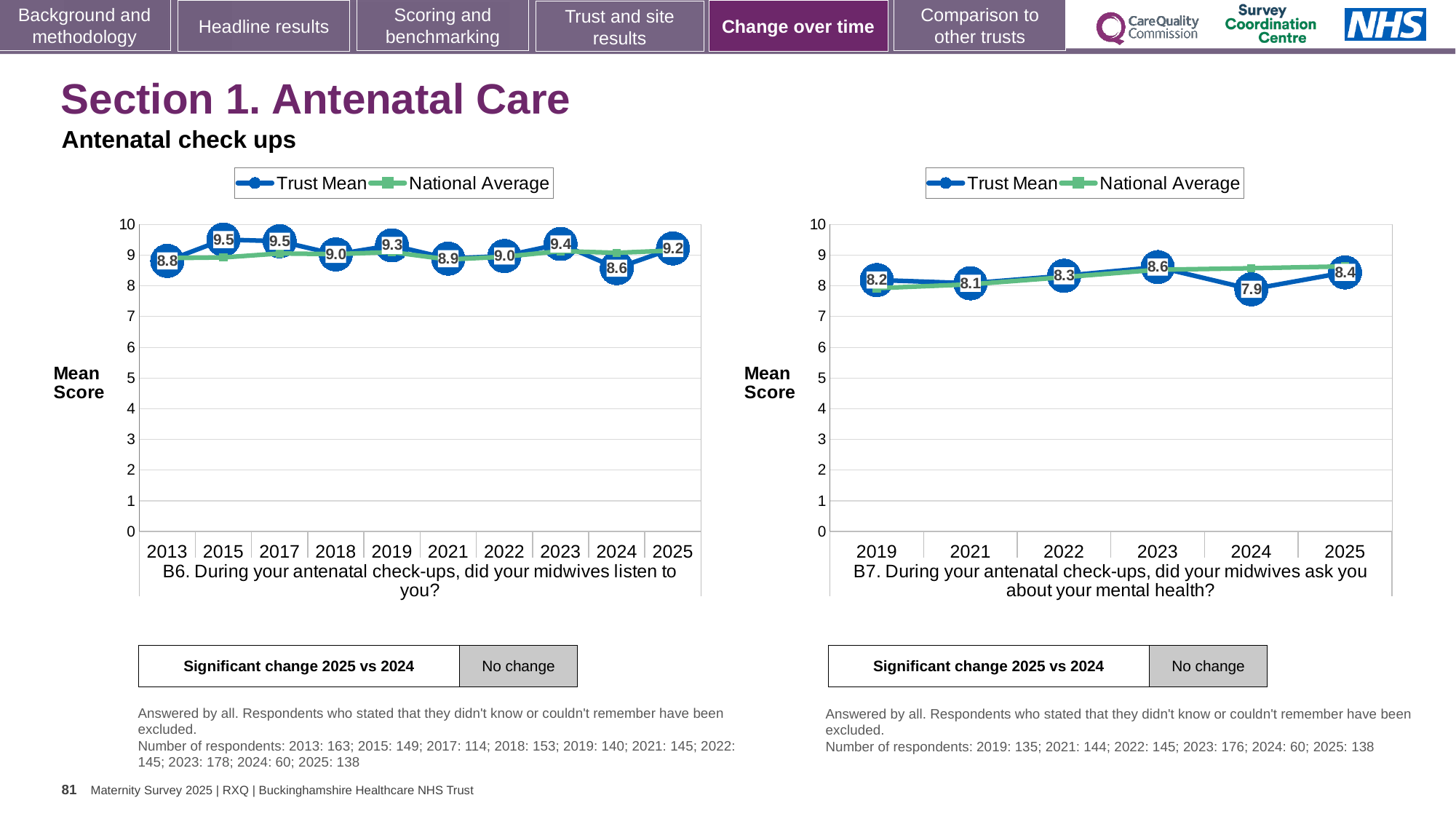
On the B7 chart (right), which year has the highest Trust Mean? 2023 How many series does the legend of the B7 chart (right) list? 2 On the B7 chart (right), which year has the lowest Trust Mean? 2024 On the B6 chart (left), which year has the lowest Trust Mean? 2024 On the B7 chart (right), is the Trust Mean for 2019 greater or less than 7? greater On the B6 chart (left), what is the Trust Mean for 2025? 9.2 On the B6 chart (left), how many years are plotted on the x axis? 10 On the B7 chart (right), what is the Trust Mean for 2024? 7.9 What type of chart is the B6 chart (left)? Line chart On the B7 chart (right), is the Trust Mean for 2022 larger or smaller than for 2021? larger On the B6 chart (left), what is the Trust Mean for 2013? 8.8 On the B6 chart (left), what is the difference between the Trust Mean in 2025 and in 2024? 0.6